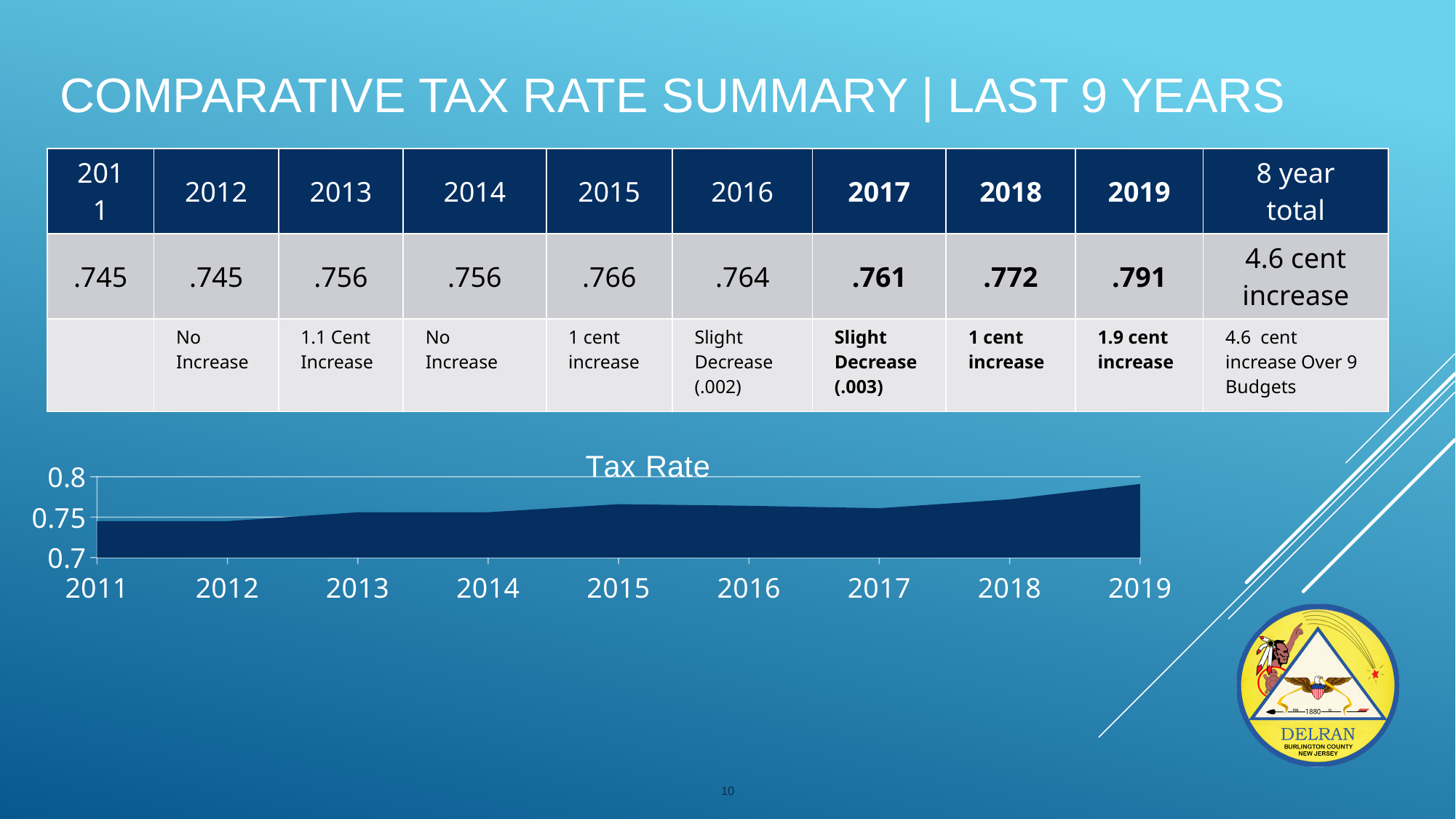
Is the value for 2019 in the chart greater or less than 0.75? greater Which is larger in the chart, the value for 2018 or the value for 2019? 2019 What is the highest value shown on the chart's y axis? 0.8 What kind of chart is shown below the table? Area chart Which year has the highest tax rate in the chart? 2019 What is the title of the chart? Tax Rate Does the tax rate generally rise or fall from 2011 to 2019 in the chart? rise Is the value for 2018 in the chart greater or less than 0.75? greater How many years are plotted along the x axis of the chart? 9 Which is larger in the chart, the value for 2019 or the value for 2011? 2019